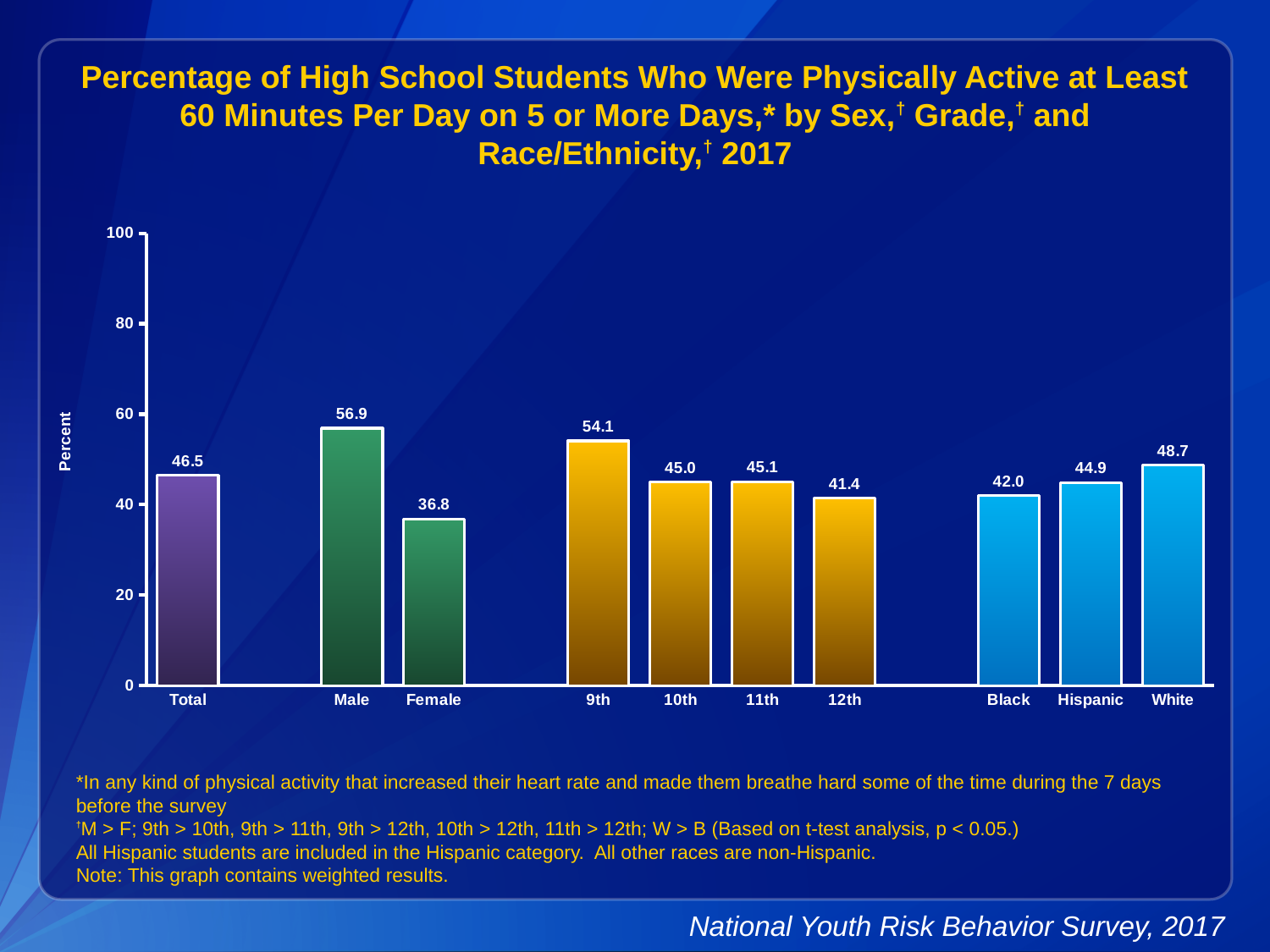
What is the value for 12th grade? 41.4 What is the value for Female? 36.8 Is the value for 9th grade greater or less than 40? greater What is the difference between the values for 9th and 12th grade? 12.7 Which category has the lowest value? Female How many bars are shown in the chart? 10 Which is larger, the value for White or the value for Black? White What kind of chart is shown on the slide? Bar chart Which category has the highest value? Male What is the value for Total? 46.5 What is the value for Hispanic? 44.9 What is the difference between the values for Male and Female? 20.1